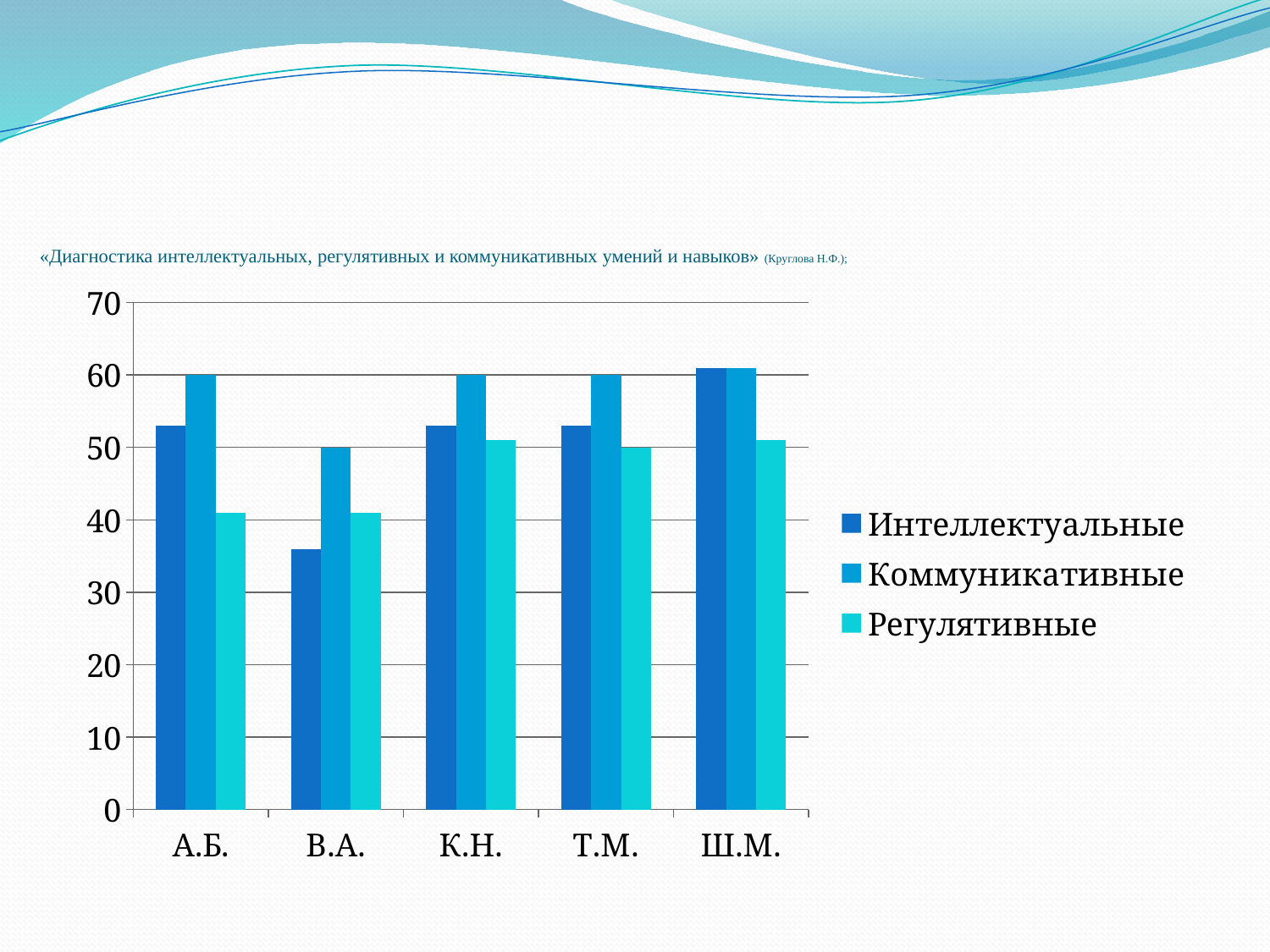
Is the value of Регулятивные for А.Б. greater or less than 50? less How many categories are shown on the x axis? 5 Which category has the highest Интеллектуальные value? Ш.М. Is the value of Интеллектуальные for В.А. greater or less than 40? less Is the value of Интеллектуальные for Ш.М. greater or less than 50? greater What is the value of Коммуникативные for В.А.? 50 Which category has the lowest Интеллектуальные value? В.А. How many series does the legend list? 3 What kind of chart is shown on the slide? bar chart Which series is shown in the lightest (cyan) colour in the legend? Регулятивные For В.А., which is larger: Коммуникативные or Интеллектуальные? Коммуникативные What is the value of Коммуникативные for А.Б.? 60